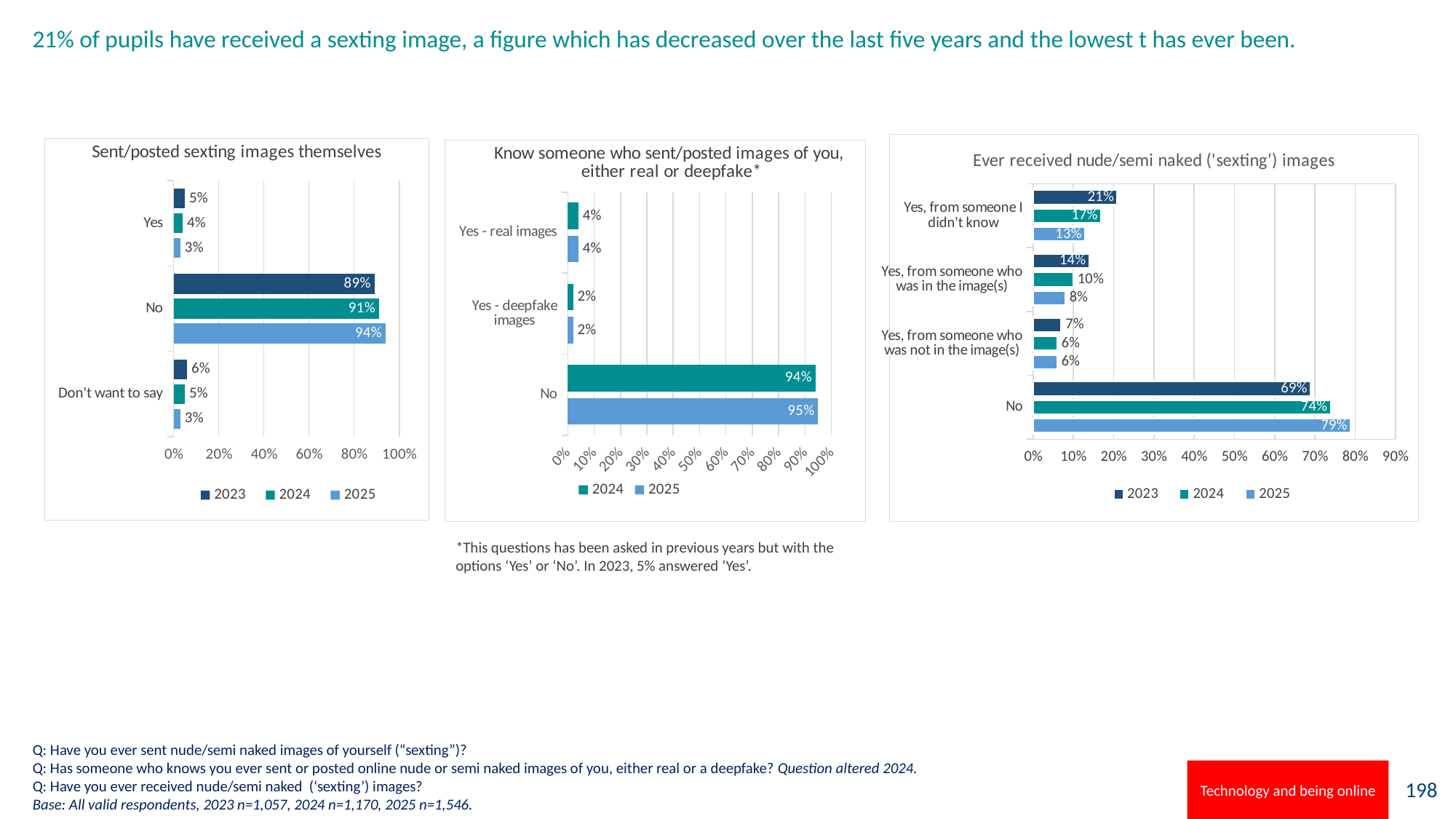
In the 'Sent/posted sexting images themselves' chart, what is the value for 'No' in 2025? 94% In the 'Ever received nude/semi naked ('sexting') images' chart, does the value for 'No' rise or fall from 2023 to 2025? rise In the 'Know someone who sent/posted images of you' chart, which category has the highest value in 2025? No In the 'Sent/posted sexting images themselves' chart, what is the difference between the 'No' values for 2025 and 2023? 5% In the 'Ever received nude/semi naked ('sexting') images' chart, how many categories are shown? 4 In the 'Ever received nude/semi naked ('sexting') images' chart, which is larger: 'Yes, from someone who was in the image(s)' in 2023 or in 2025? 2023 In the 'Ever received nude/semi naked ('sexting') images' chart, what is the value for 'Yes, from someone I didn't know' in 2023? 21% In the 'Sent/posted sexting images themselves' chart, what is the value for 'Yes' in 2023? 5% In the 'Know someone who sent/posted images of you' chart, how many series does the legend list? 2 What kind of chart is the 'Sent/posted sexting images themselves' chart? bar chart In the 'Know someone who sent/posted images of you' chart, what is the value for 'Yes - deepfake images' in 2024? 2% In the 'Ever received nude/semi naked ('sexting') images' chart, what is the value for 'No' in 2024? 74%